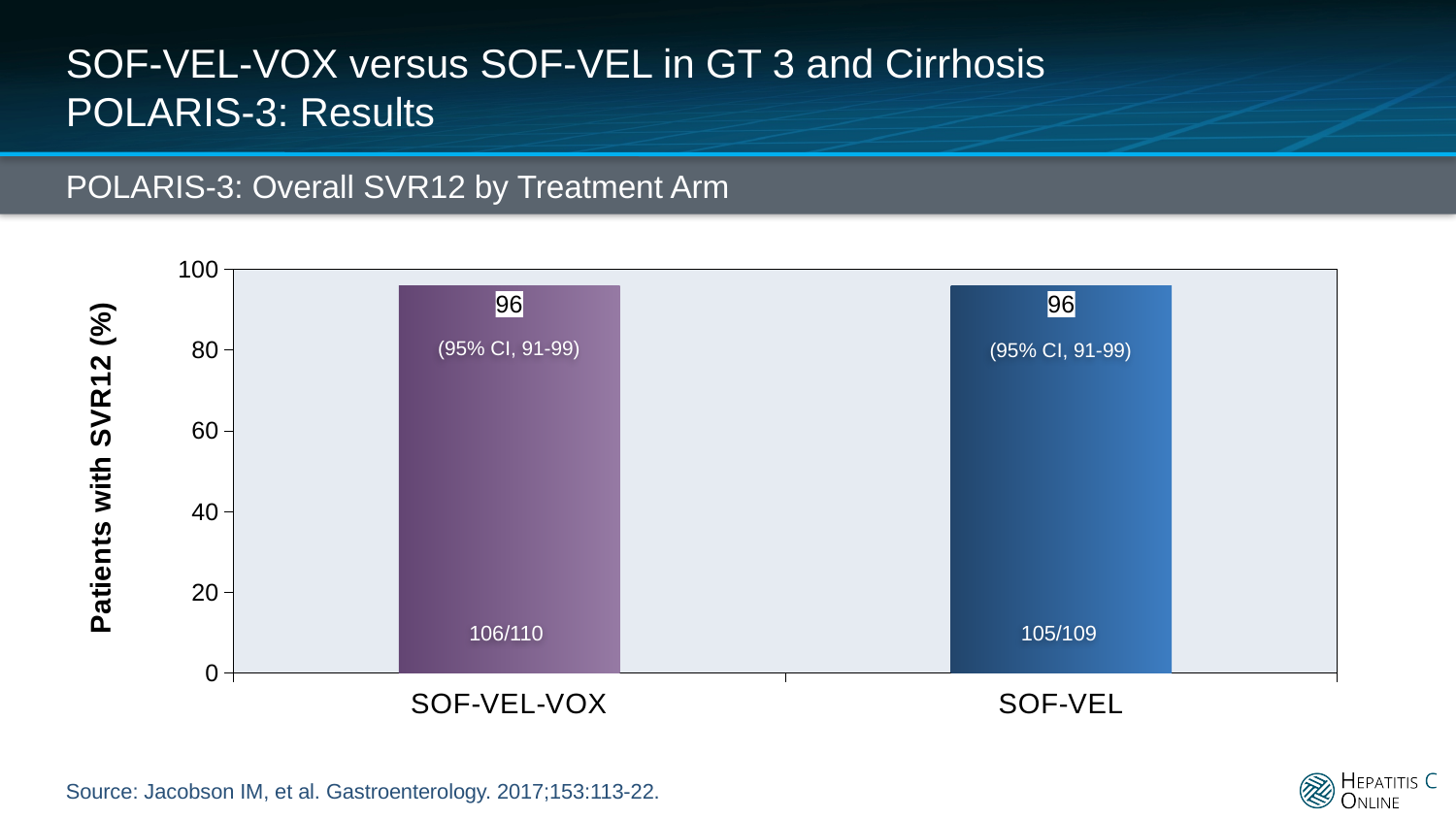
What is the difference between the SVR12 values for SOF-VEL-VOX and SOF-VEL? 0 What is the SVR12 value for SOF-VEL? 96 What is the label of the y axis? Patients with SVR12 (%) What fraction of patients is shown inside the SOF-VEL-VOX bar? 106/110 Is the value for SOF-VEL greater or less than 100? less What fraction of patients is shown inside the SOF-VEL bar? 105/109 What is the 95% confidence interval shown for SOF-VEL-VOX? 91-99 What kind of chart is shown on the slide? Bar chart What is the SVR12 value for SOF-VEL-VOX? 96 Is the value for SOF-VEL-VOX greater or less than 80? greater What is the title of the chart? POLARIS-3: Overall SVR12 by Treatment Arm How many treatment arms are shown on the x axis? 2